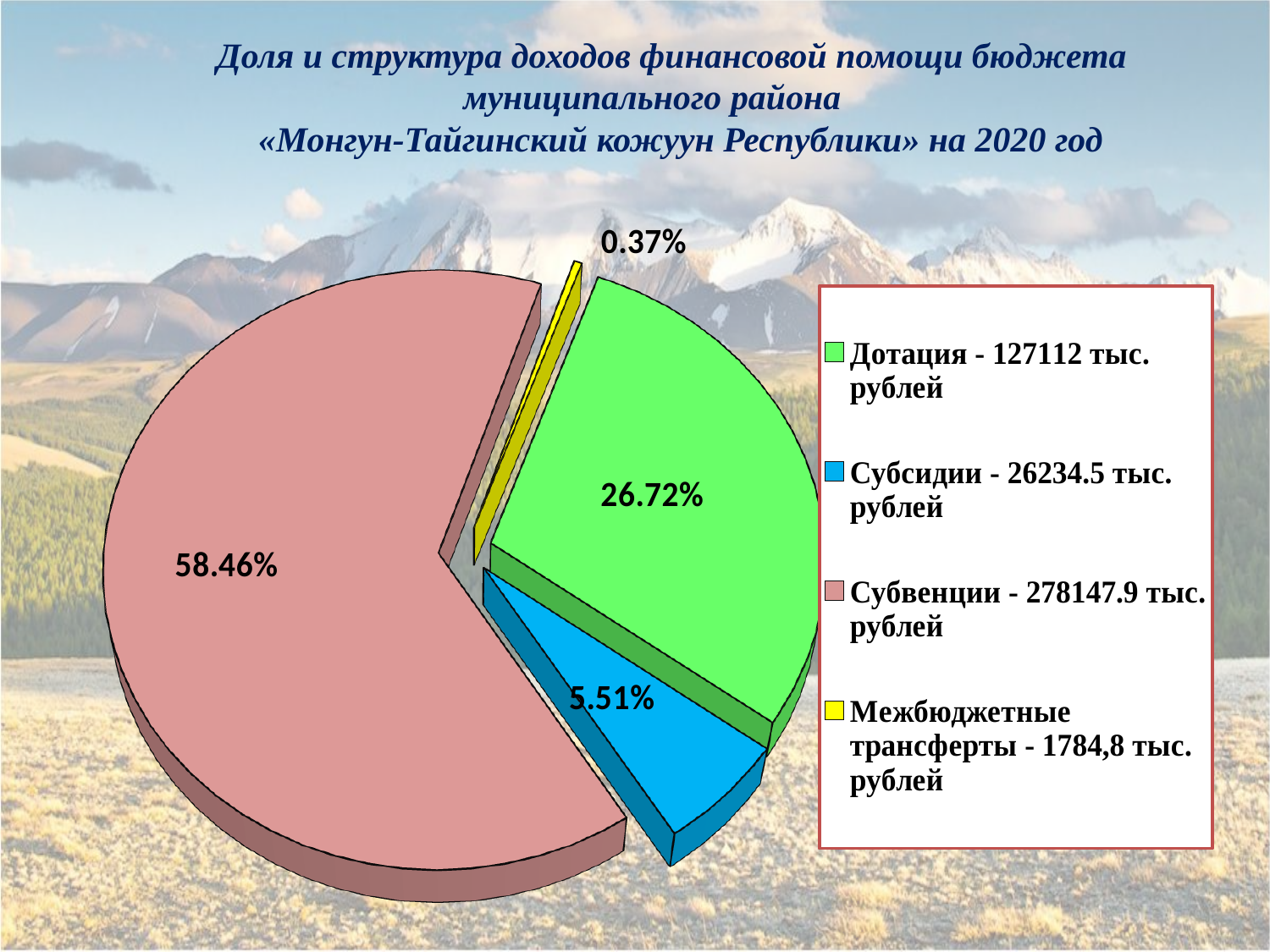
What share of the pie does Субвенции have? 58.46% What is the difference in percentage points between the shares of Субвенции and Дотация? 31.74 Which category has the largest share of the pie? Субвенции What colour is the slice for Дотация? green What share of the pie does Субсидии have? 5.51% Which category has the smallest share of the pie? Межбюджетные трансферты What share of the pie does Межбюджетные трансферты have? 0.37% Which has a larger share: Дотация or Субсидии? Дотация What kind of chart is shown on the slide? pie chart According to the legend, what is the amount for Субсидии? 26234.5 тыс. рублей How many slices does the pie chart have? 4